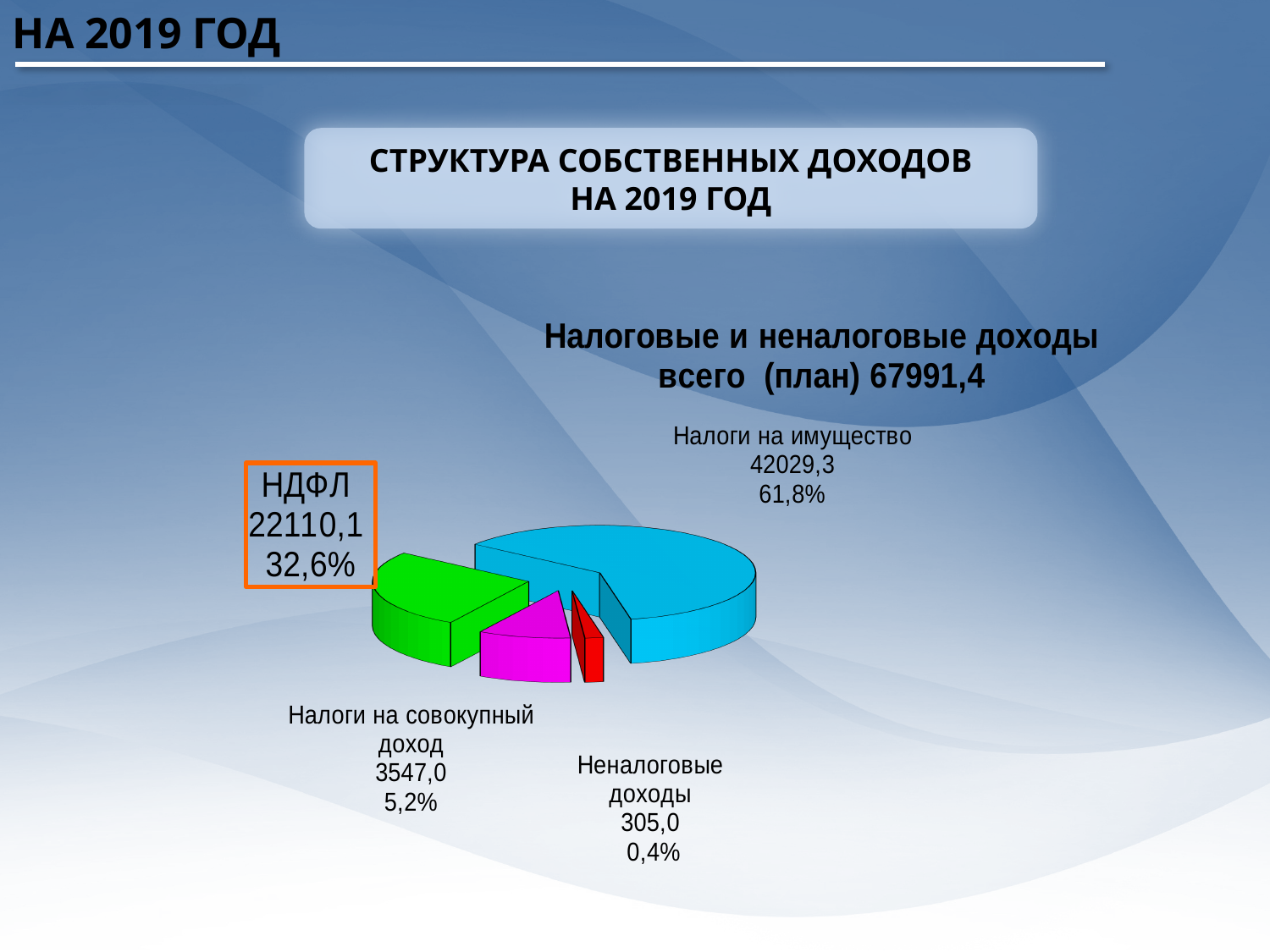
How many slices does the pie chart have? 4 What is the value for Неналоговые доходы? 305,0 What share of the pie does Налоги на имущество represent? 61,8% What share of the pie does НДФЛ represent? 32,6% What total (план) is stated in the chart title? 67991,4 Which category has the smallest slice of the pie? Неналоговые доходы What kind of chart is shown on the slide? pie chart What is the value for Налоги на совокупный доход? 3547,0 What is the value for НДФЛ? 22110,1 What is the value for Налоги на имущество? 42029,3 Which category has the largest slice of the pie? Налоги на имущество Which is larger, the value for НДФЛ or the value for Налоги на совокупный доход? НДФЛ